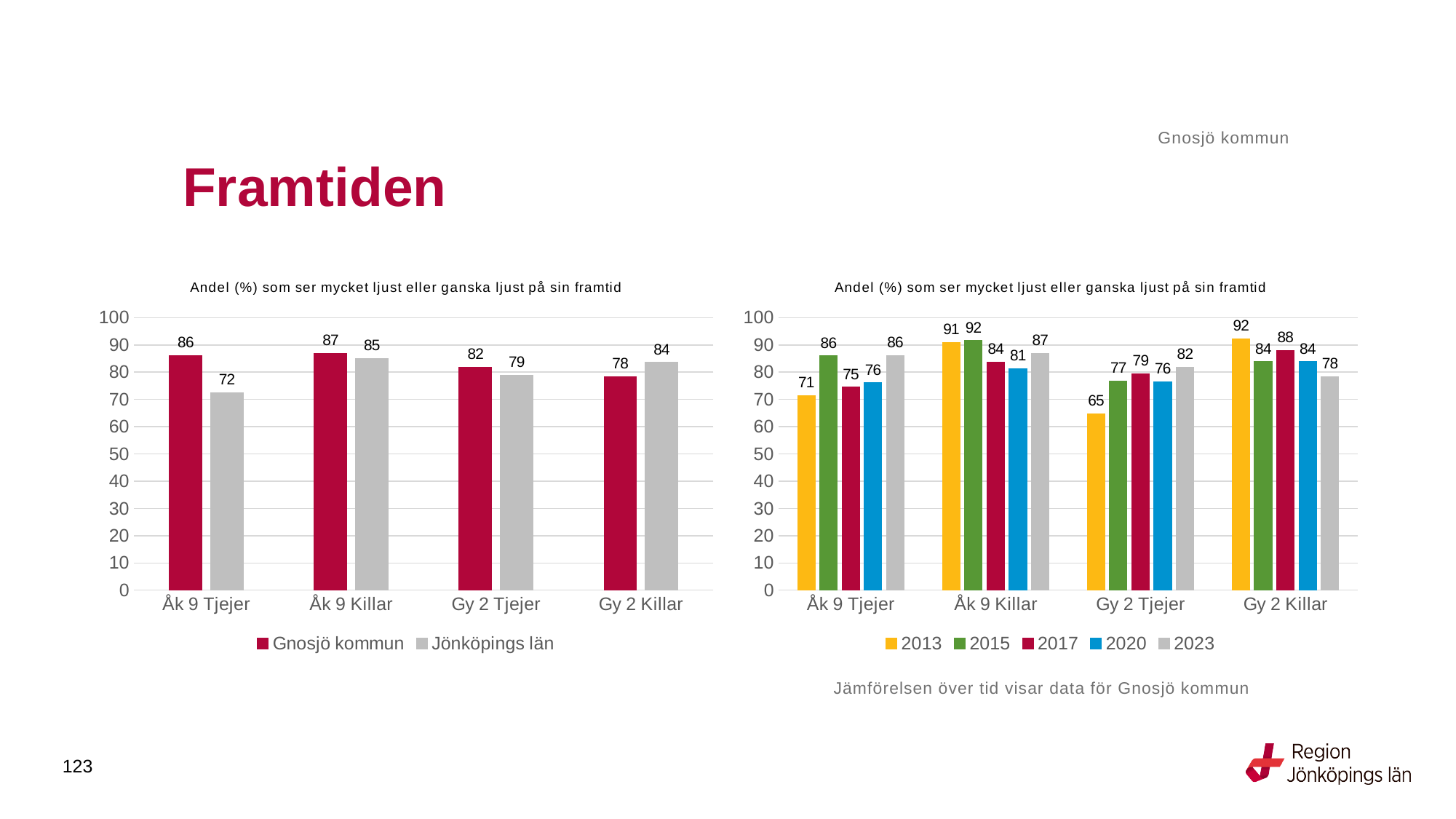
In the left chart, what is the difference between Gnosjö kommun and Jönköpings län for Åk 9 Tjejer? 14 In the left chart, what is the value for Jönköpings län for Gy 2 Killar? 84 In the right chart, what is the difference between the 2013 and 2015 values for Åk 9 Tjejer? 15 In the left chart, which category has the lowest value for Jönköpings län? Åk 9 Tjejer In the left chart, which is larger for Gy 2 Killar: Gnosjö kommun or Jönköpings län? Jönköpings län What kind of chart is the right chart? Bar chart In the right chart, what is the value for 2023 for Åk 9 Killar? 87 In the left chart, what is the value for Gnosjö kommun for Åk 9 Tjejer? 86 In the right chart, which category has the highest value for 2013? Gy 2 Killar In the right chart, what is the value for 2013 for Gy 2 Tjejer? 65 How many series does the legend of the right chart list? 5 How many series does the legend of the left chart list? 2